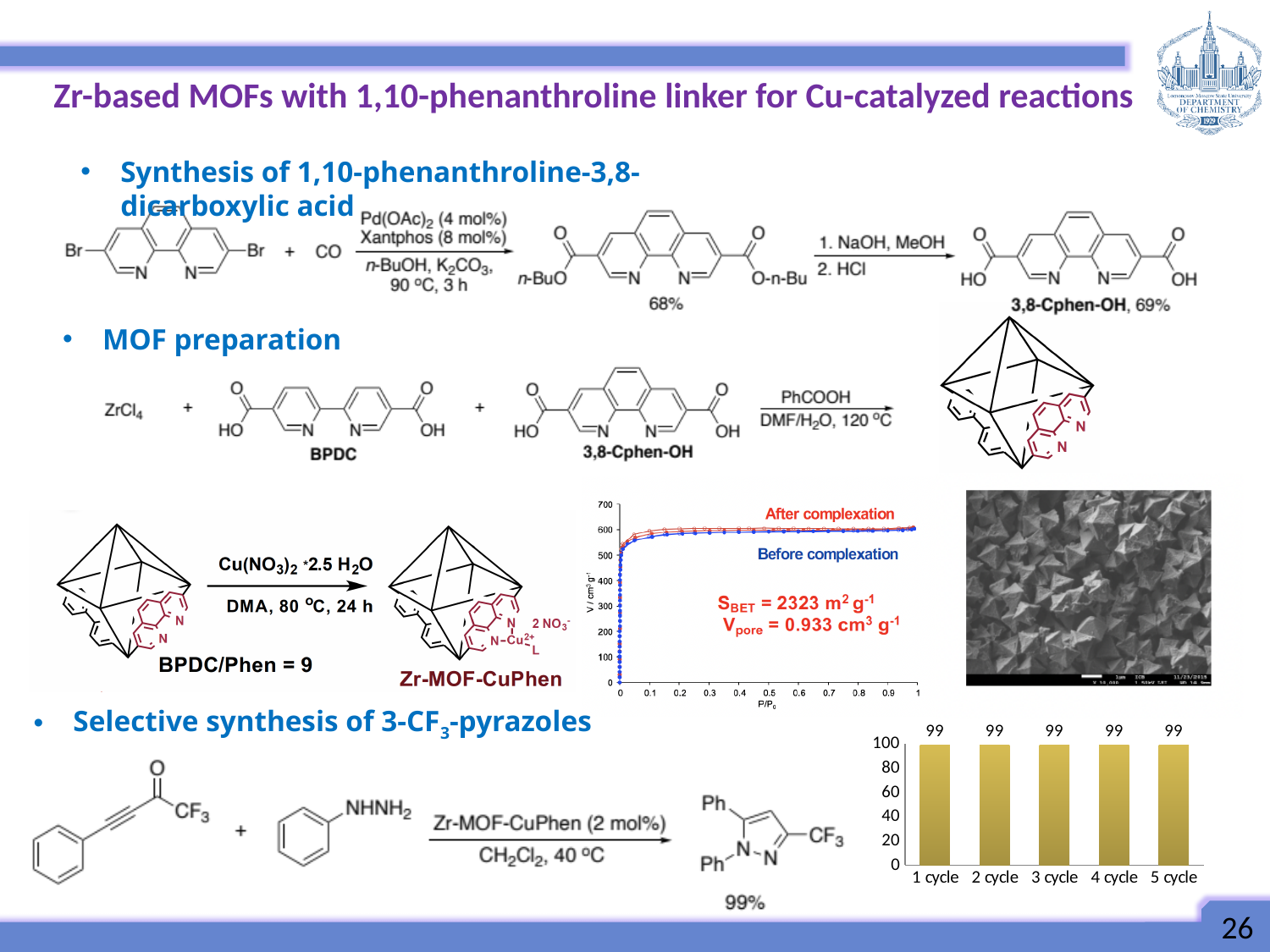
In the bar chart at the bottom right of the slide, what is the difference between the values for 1 cycle and 5 cycle? 0 In the adsorption chart with the P/P0 axis, is the value of the After complexation curve at P/P0 = 0.5 greater or less than 500? greater In the bar chart at the bottom right of the slide, what is the value for 3 cycle? 99 In the bar chart at the bottom right of the slide, what is the value for 1 cycle? 99 How many series are labelled in the adsorption chart with the P/P0 axis? 2 In the bar chart at the bottom right of the slide, what is the value for 5 cycle? 99 What kind of chart is the chart at the bottom right of the slide showing cycles? bar chart In the bar chart at the bottom right of the slide, do the values rise, fall or stay the same from 1 cycle to 5 cycle? stay the same How many categories (cycles) are shown in the bar chart at the bottom right of the slide? 5 What are the two series labelled in the adsorption chart with the P/P0 axis? After complexation and Before complexation What kind of chart is the adsorption chart in the middle right of the slide with the P/P0 axis? line chart In the bar chart at the bottom right of the slide, is the value for 2 cycle greater or less than 80? greater